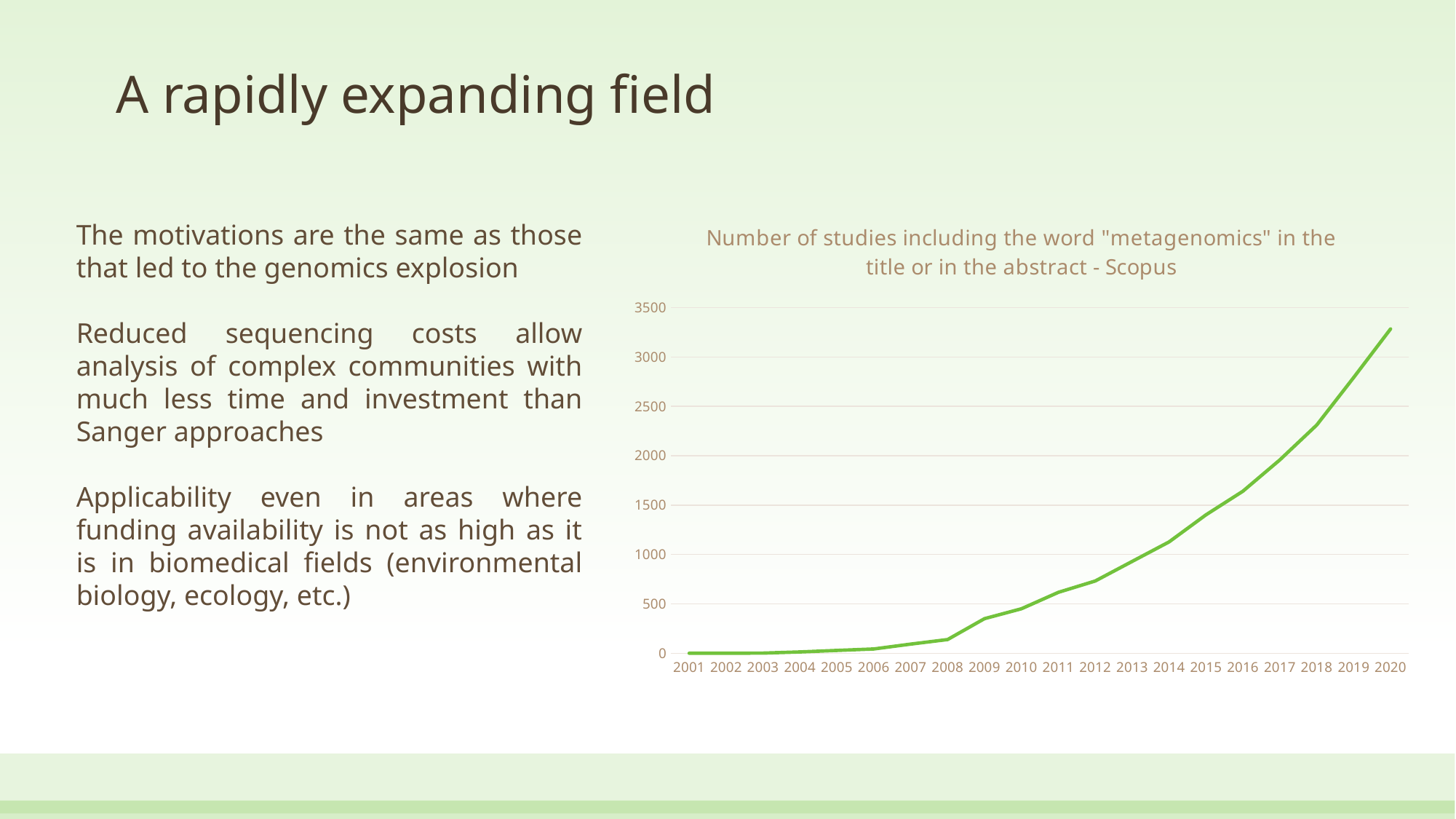
Is the value for 2019 greater or less than 3000? less Do the values in the chart generally rise or fall from 2001 to 2020? rise Is the value for 2012 greater or less than 1000? less Is the value for 2008 greater or less than 500? less What is the first year shown on the x axis of the chart? 2001 How many years are plotted along the x axis of the chart? 20 Which year has the highest number of studies in the chart? 2020 What is the title of the chart? Number of studies including the word "metagenomics" in the title or in the abstract - Scopus Which year has the larger value, 2010 or 2017? 2017 What kind of chart is shown on the slide? line chart